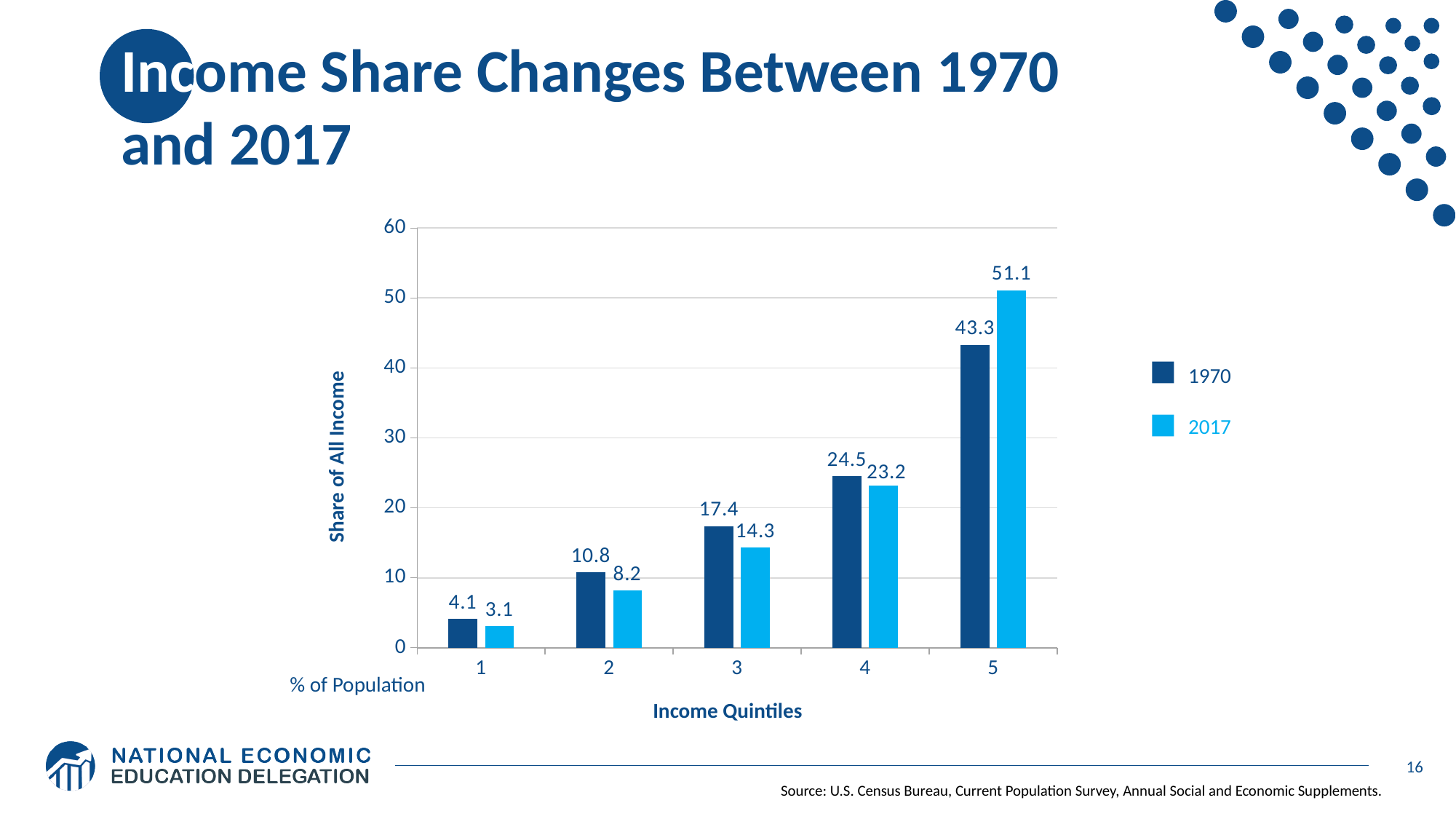
What is the 2017 value for income quintile 3? 14.3 What is the 2017 income share for income quintile 1? 3.1 For income quintile 4, which year has the larger income share, 1970 or 2017? 1970 What is the 1970 income share for income quintile 5? 43.3 Which income quintile has the lowest 1970 income share? 1 Which income quintile has the highest 2017 income share? 5 How many series does the legend list? 2 What kind of chart is shown on the slide? Bar chart What is the difference between the 1970 and 2017 income shares for quintile 2? 2.6 What is the difference between the 2017 and 1970 income shares for quintile 5? 7.8 Is the 2017 value for income quintile 5 greater or less than 50? greater How many income quintiles are shown on the x axis? 5